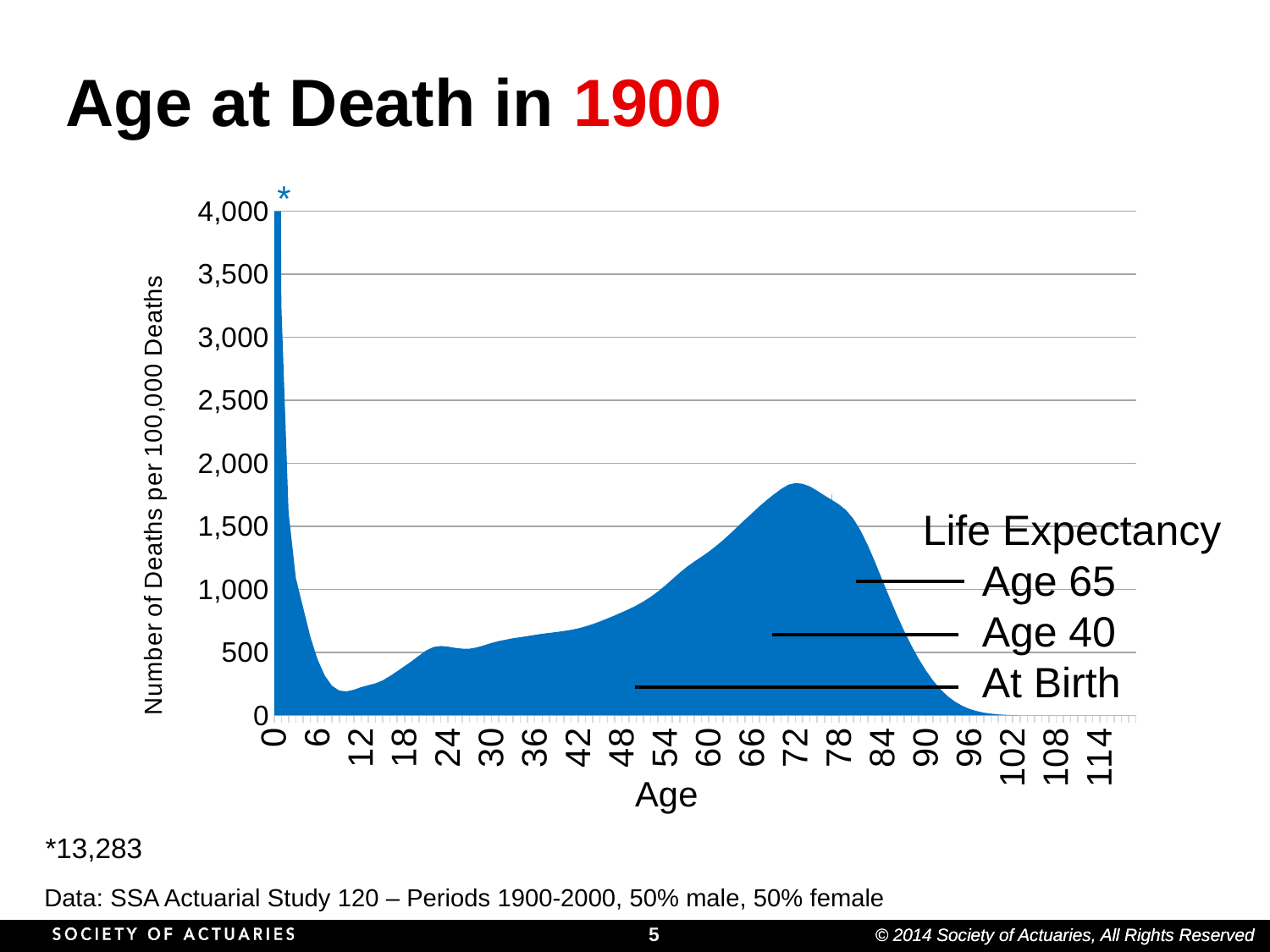
Is the value at age 24 greater or less than 1,000? less What is the title of the chart on the slide? Age at Death in 1900 Is the value at age 72 greater or less than 1,500? greater Is the value at age 12 greater or less than 500? less Which age has a higher number of deaths per 100,000 deaths, age 72 or age 24? 72 Between age 0 and age 6, do the values rise or fall as age increases? fall According to the footnote, what is the number of deaths per 100,000 deaths at age 0? 13,283 What is the label of the vertical axis of the chart? Number of Deaths per 100,000 Deaths Between age 36 and age 72, do the values rise or fall as age increases? rise At which age is the number of deaths per 100,000 deaths highest? 0 What kind of chart is shown on the slide? area chart